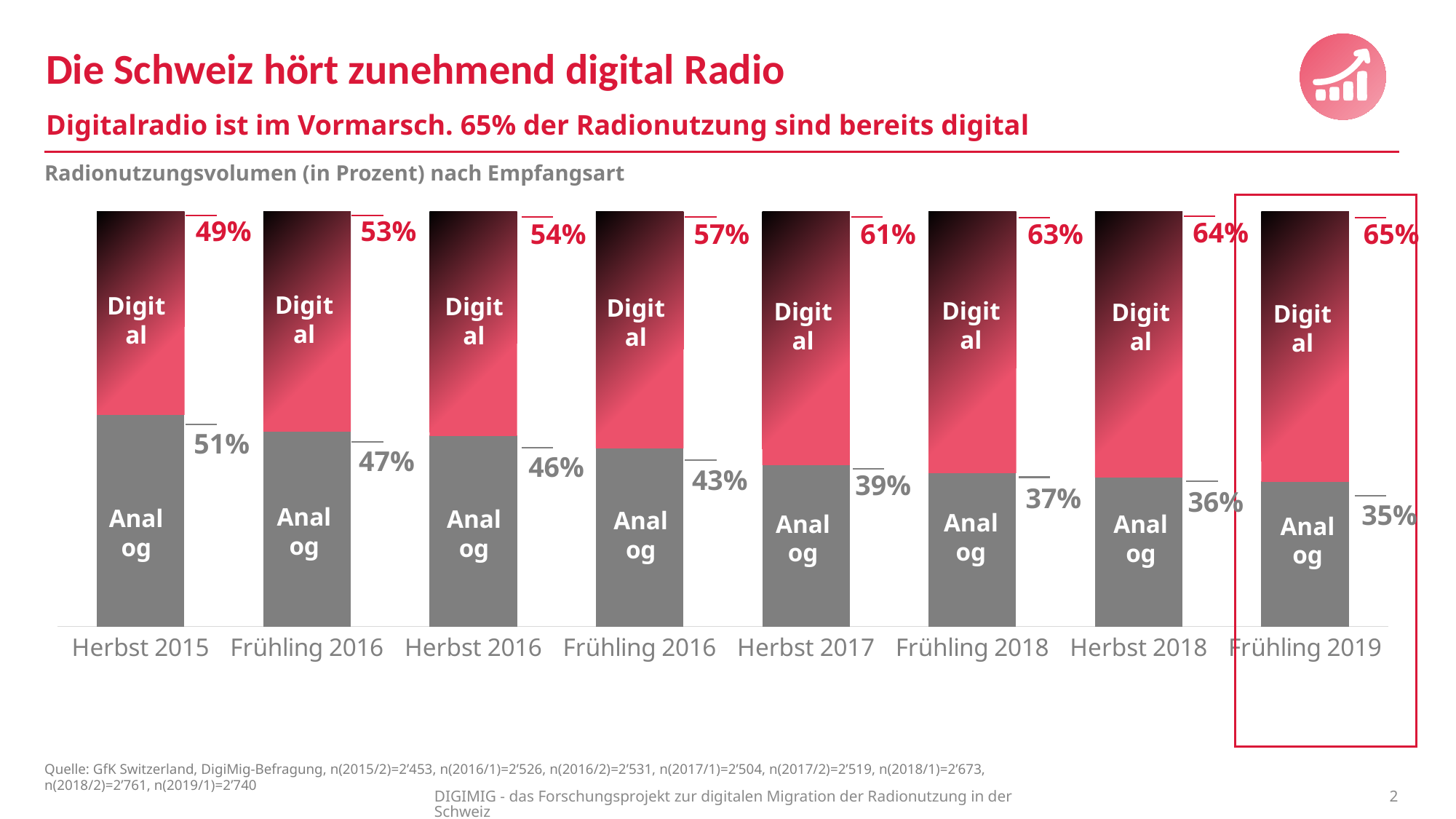
What is the total of the Digital and Analog shares for Herbst 2018? 100% In which period is the Analog share lowest? Frühling 2019 What type of chart is shown on the slide? Stacked bar chart By how many percentage points did the Digital share grow from Herbst 2015 to Frühling 2019? 16 percentage points In Herbst 2018, which is larger, the Digital share or the Analog share? Digital In which period is the Digital share highest? Frühling 2019 Does the Digital share rise or fall from Herbst 2015 to Frühling 2019? Rises What is the Digital share for Herbst 2017? 61% What is the Digital share for Herbst 2015? 49% What is the Analog share for Frühling 2019? 35% How many time periods are shown on the x axis? 8